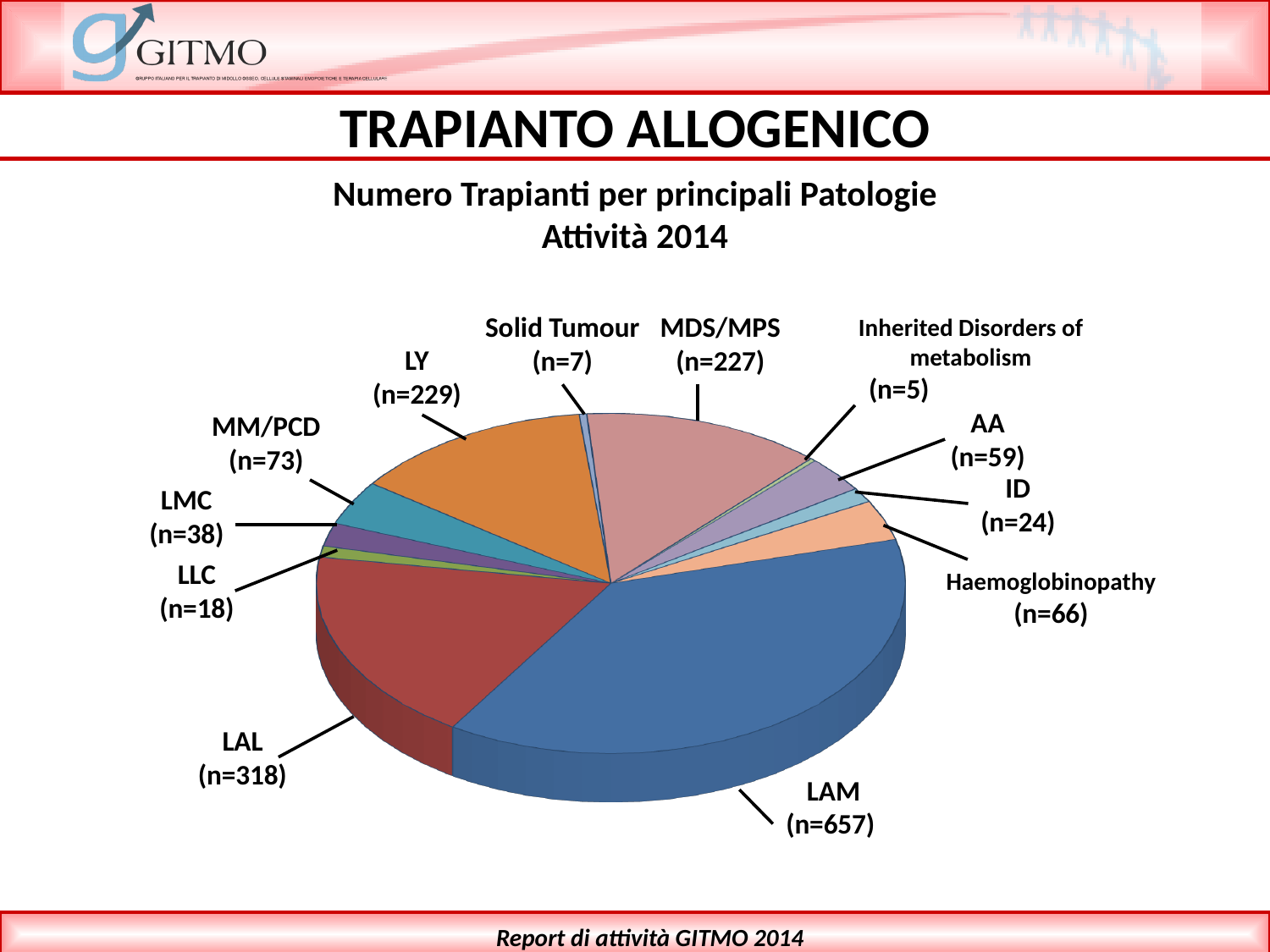
What is the title of the chart? Numero Trapianti per principali Patologie Attività 2014 Which pathology has the largest slice of the pie? LAM How many transplants are shown for LAM? 657 What is the value shown for Haemoglobinopathy? 66 What is the value shown for Solid Tumour? 7 What is the difference between the values for LAM and LAL? 339 What is the difference between the values for LY and MDS/MPS? 2 What type of chart is shown on the slide? Pie chart How many pathology categories are shown in the pie chart? 12 What is the value shown for MDS/MPS? 227 Which is larger, the value for LAL or the value for MDS/MPS? LAL Which pathology has the smallest slice of the pie? Inherited Disorders of metabolism